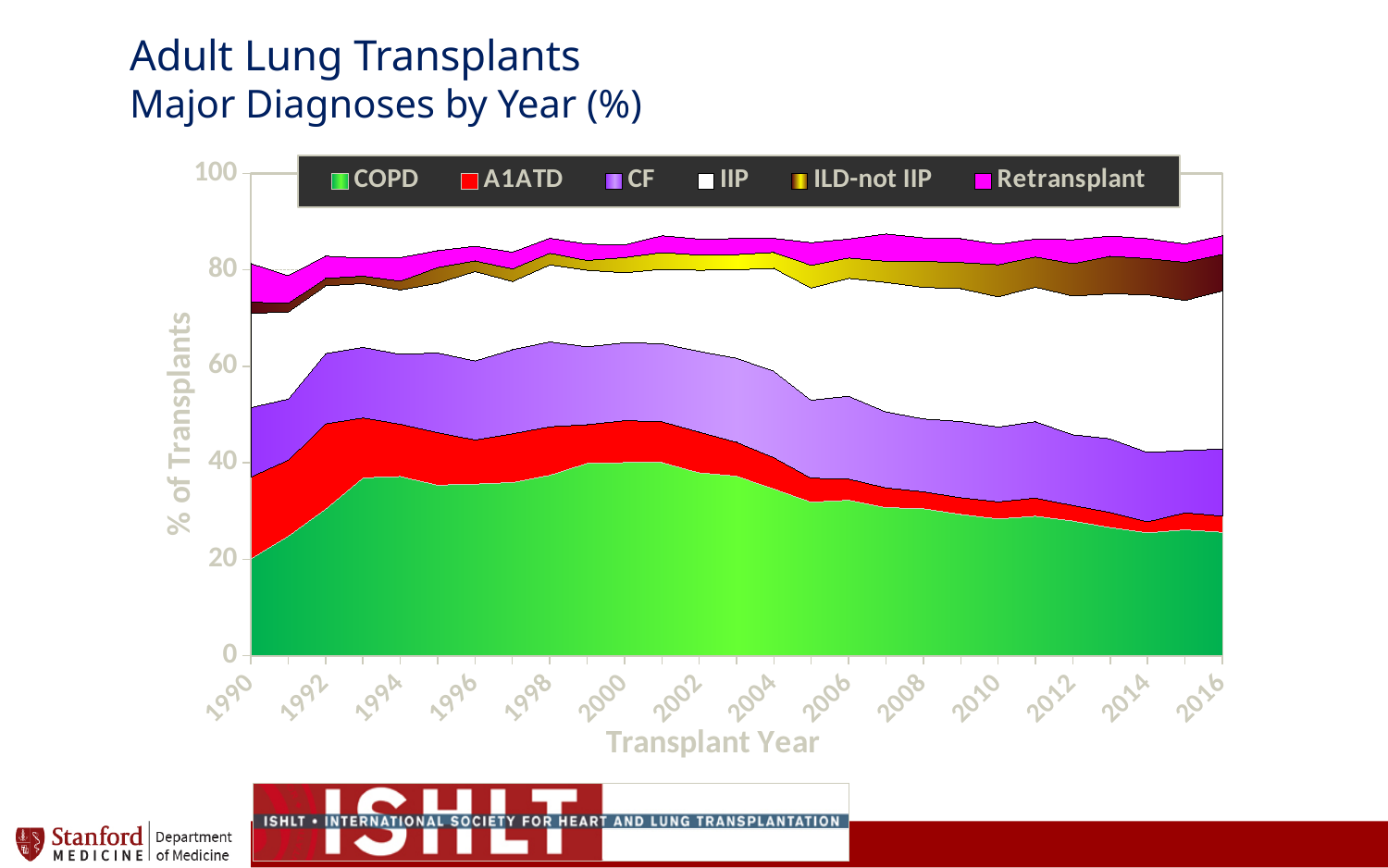
Is the cumulative top of the CF area in 2000 greater or less than 60? greater Does the COPD share rise or fall from 2000 to 2016? fall Is the COPD share in 1994 greater or less than 40? less Which is larger in 2016, the COPD share or the A1ATD share? COPD What is the label of the x axis? Transplant Year How many year labels are shown along the x axis? 14 Is the combined share of all six diagnoses in 2008 greater or less than 80? greater How many series does the legend list? 6 What kind of chart is shown on the slide? Stacked area chart Which diagnosis is shown at the bottom of the stack (the green area)? COPD Does the COPD share rise or fall from 1990 to 1993? rise